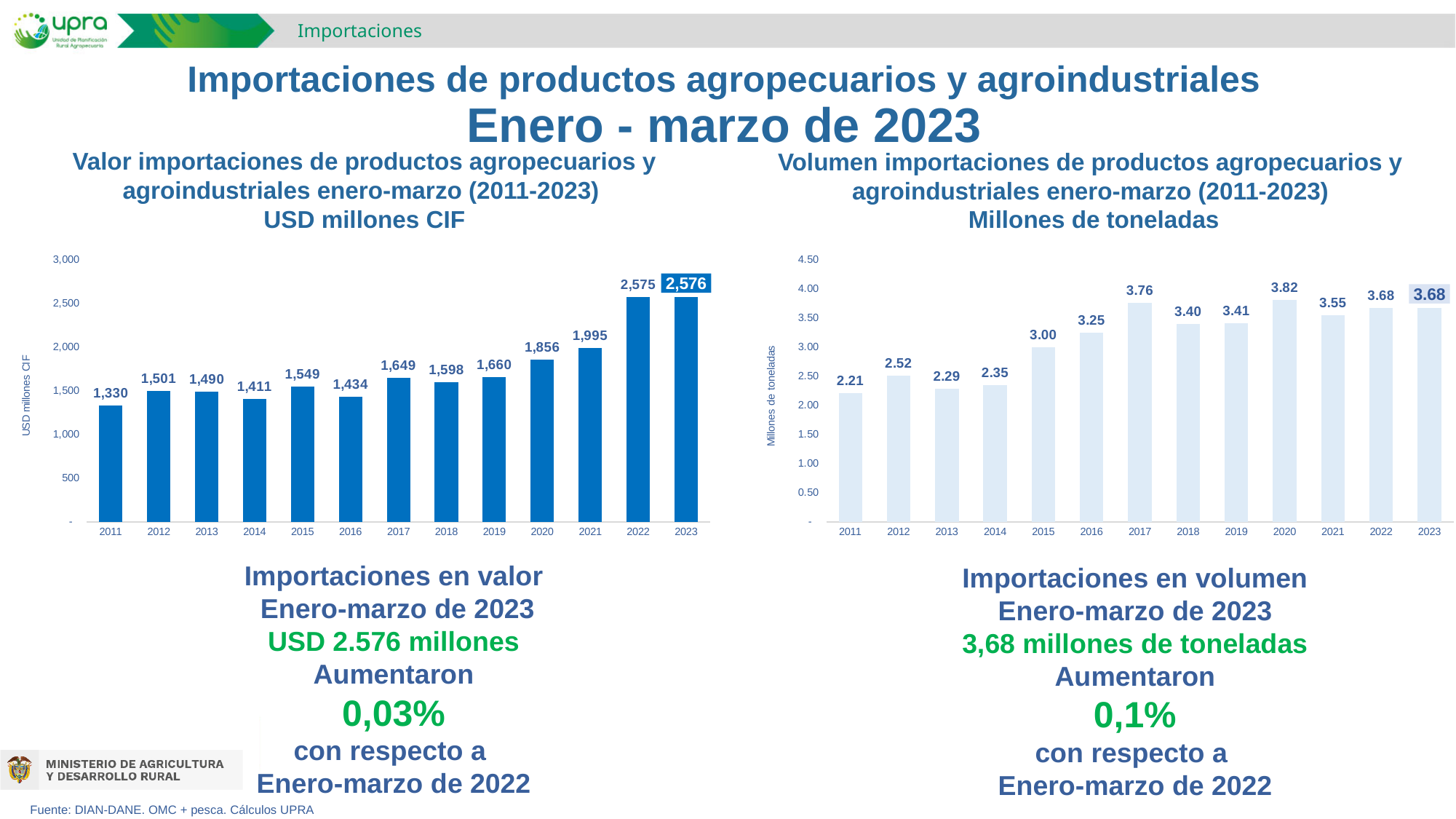
In the right chart (Volumen importaciones), what is the difference between the 2015 and 2014 values? 0.65 In the right chart (Volumen importaciones), which year has the lowest value? 2011 In the left chart (Valor importaciones), which is larger, the value for 2017 or the value for 2018? 2017 What type of chart is the right chart (Volumen importaciones)? bar chart In the left chart (Valor importaciones), which year has the lowest value? 2011 In the right chart (Volumen importaciones), what is the value for 2017? 3.76 In the left chart (Valor importaciones), what is the difference between the 2022 and 2021 values? 580 In the left chart (Valor importaciones), how many years are plotted? 13 In the left chart (Valor importaciones), what is the value for 2011? 1,330 In the left chart (Valor importaciones), what is the value for 2020? 1,856 What unit is shown on the y-axis of the right chart (Volumen importaciones)? Millones de toneladas In the right chart (Volumen importaciones), which year has the highest value? 2020